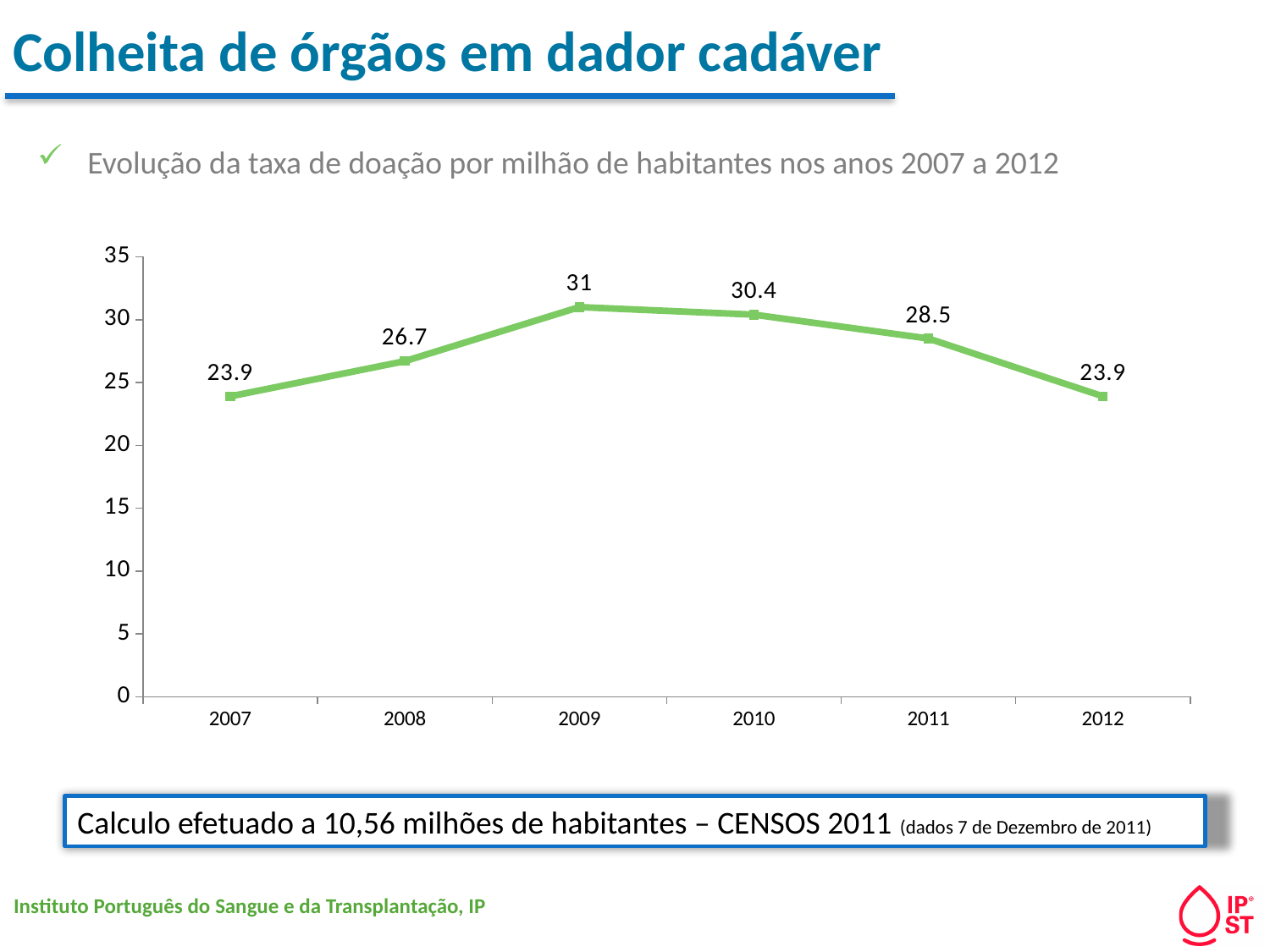
What value is plotted for 2011? 28.5 Which year has the highest value on the chart? 2009 Is the value for 2010 greater or less than 25? greater What value is plotted for 2008? 26.7 What kind of chart is shown on the slide? line chart Do the values rise or fall from 2009 to 2012? fall Which is larger, the value for 2010 or the value for 2011? 2010 What is the difference between the values for 2008 and 2007? 2.8 What is the lowest value shown on the chart? 23.9 What is the donation rate per million inhabitants shown for 2009? 31 What is the difference between the values for 2009 and 2012? 7.1 How many years are plotted on the chart? 6